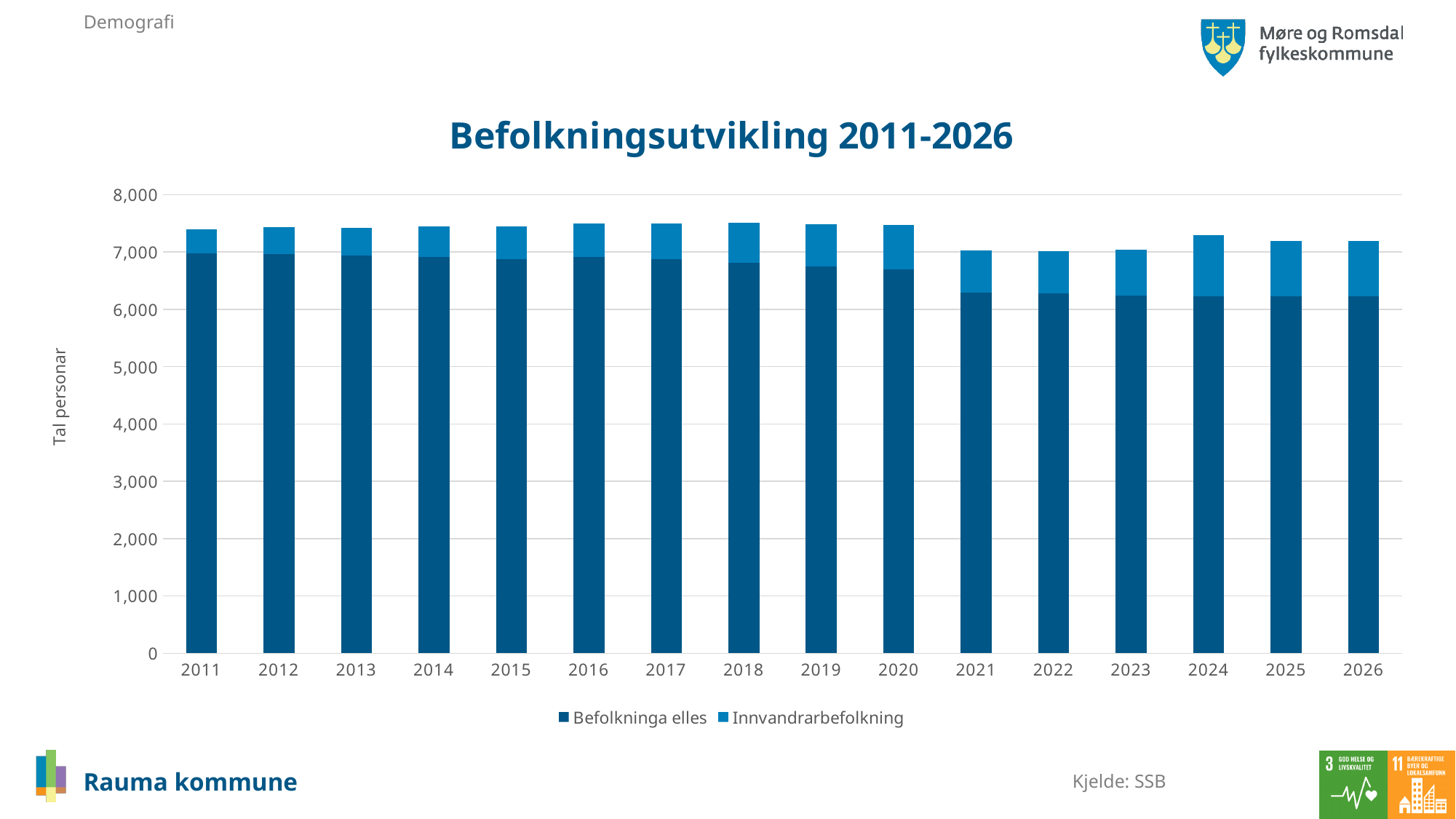
Which is larger, the value for Innvandrarbefolkning in 2011 or in 2026? 2026 How many years are shown on the x axis of the chart? 16 Is the total height of the stacked bar for 2018 greater or less than 7,000? greater Which is larger, the value for Befolkninga elles in 2011 or in 2026? 2011 Is the value for Befolkninga elles in 2026 greater or less than 7,000? less Is the value for Befolkninga elles in 2021 greater or less than 6,000? greater What is the title of the chart? Befolkningsutvikling 2011-2026 What is the label on the vertical axis of the chart? Tal personar How many series does the legend list? 2 Does the value for Befolkninga elles generally rise or fall from 2011 to 2026? fall What kind of chart is shown on the slide? Stacked bar chart